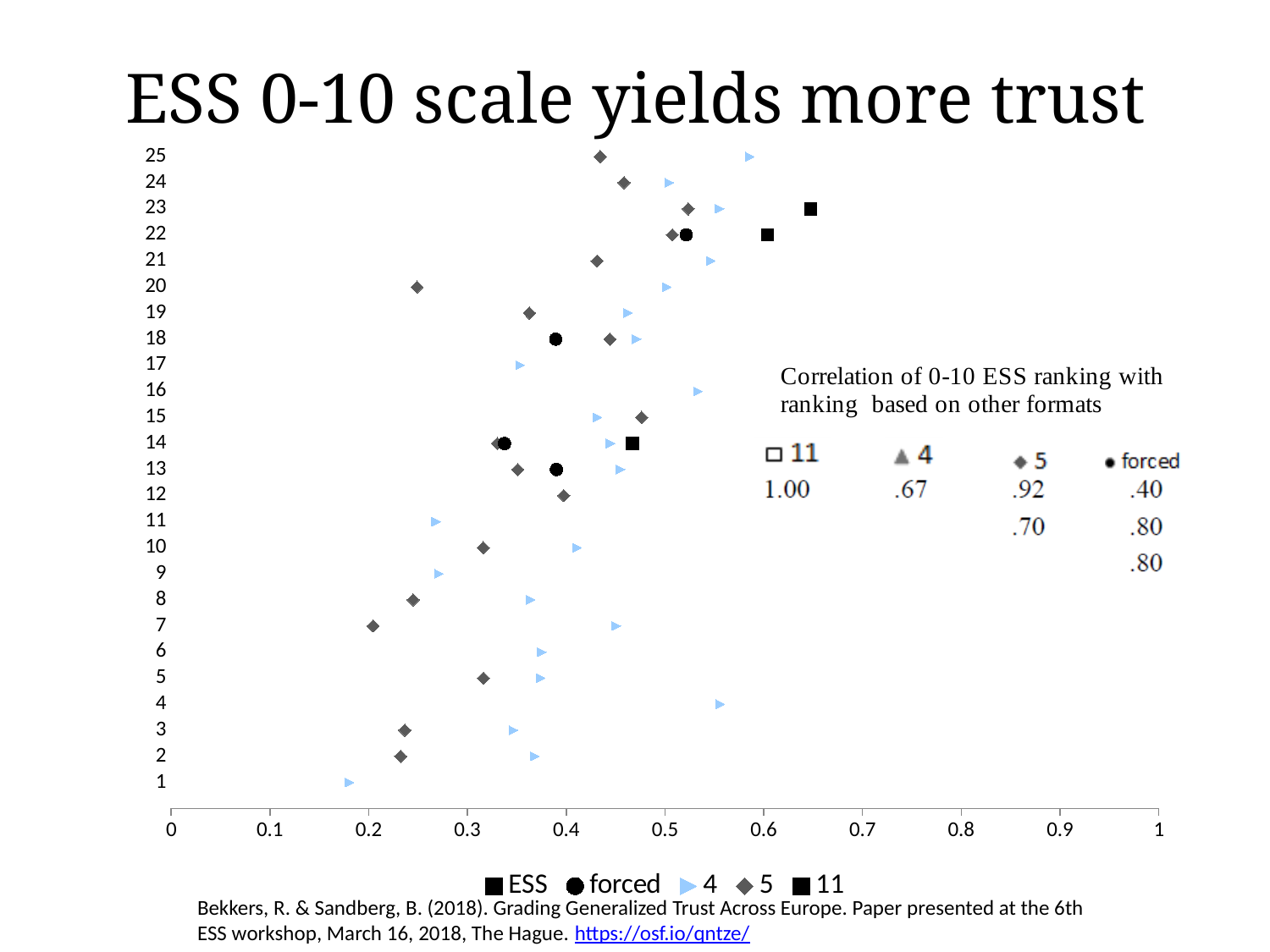
How many series does the chart legend list? 5 Is the value for the '4' series point at rank 4 greater or less than 0.5? greater Is the value for the '11' series point at rank 23 greater or less than 0.6? greater What is the highest value shown on the chart's vertical axis? 25 Is the value for the '5' series point at rank 20 greater or less than 0.3? less According to the text box on the slide, what is the correlation of the 0-10 ESS ranking with the ranking based on the 11 format? 1.00 What is the title of the slide containing the chart? ESS 0-10 scale yields more trust Which series contains the point with the lowest value on the horizontal axis? 4 What kind of chart is shown on the slide? scatter chart